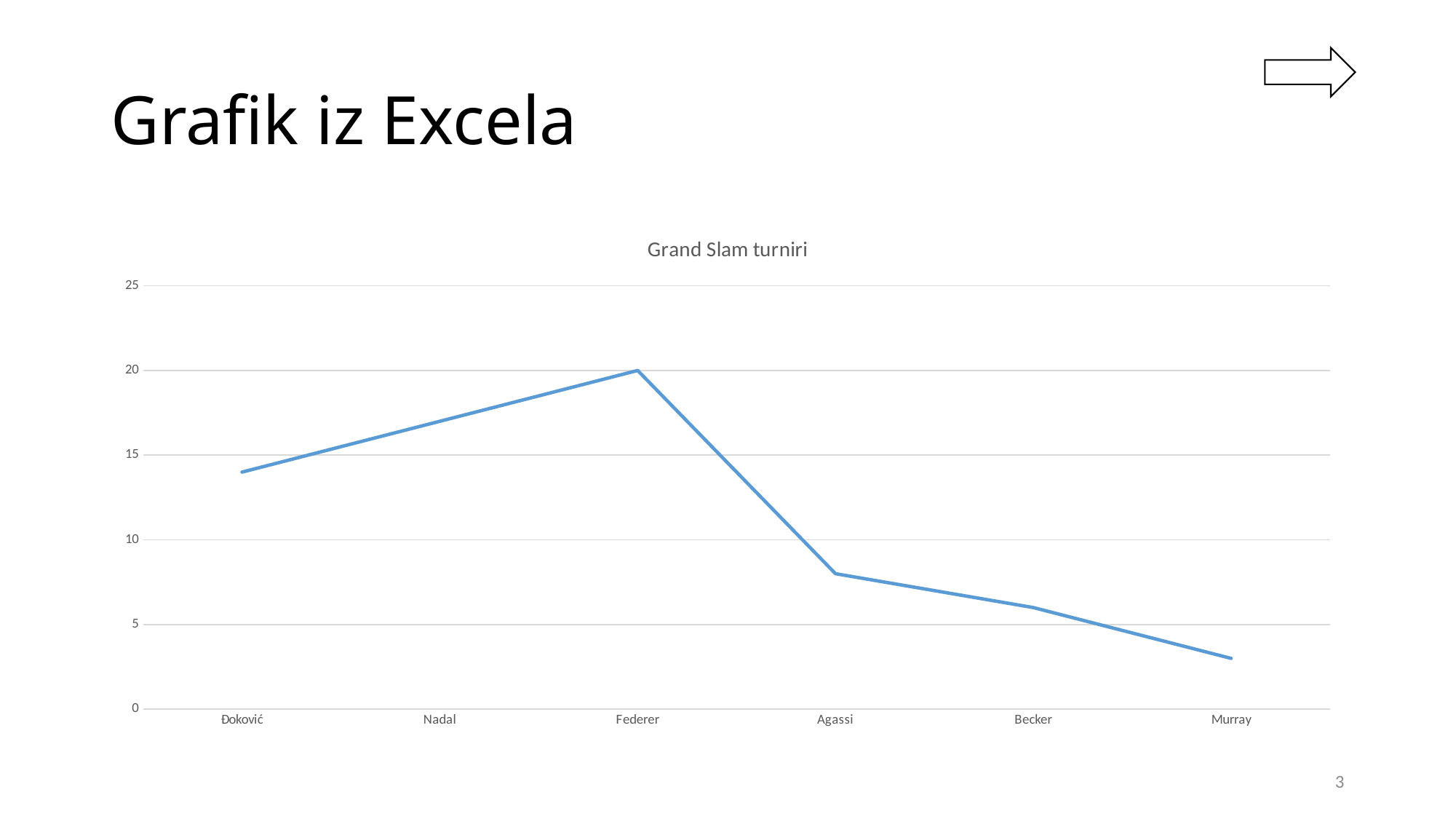
How many players are shown on the x axis of the chart? 6 Which has a larger value, Đoković or Agassi? Đoković Do the values rise or fall along the x axis from Federer to Murray? fall Which player has the highest value in the chart? Federer Is the value for Đoković greater or less than 10? greater Which player has the lowest value in the chart? Murray Which has a larger value, Nadal or Becker? Nadal Is the value for Agassi greater or less than 10? less What is the value for Federer in the chart? 20 What is the title of the chart? Grand Slam turniri What kind of chart is shown on the slide? line chart Is the value for Murray greater or less than 5? less